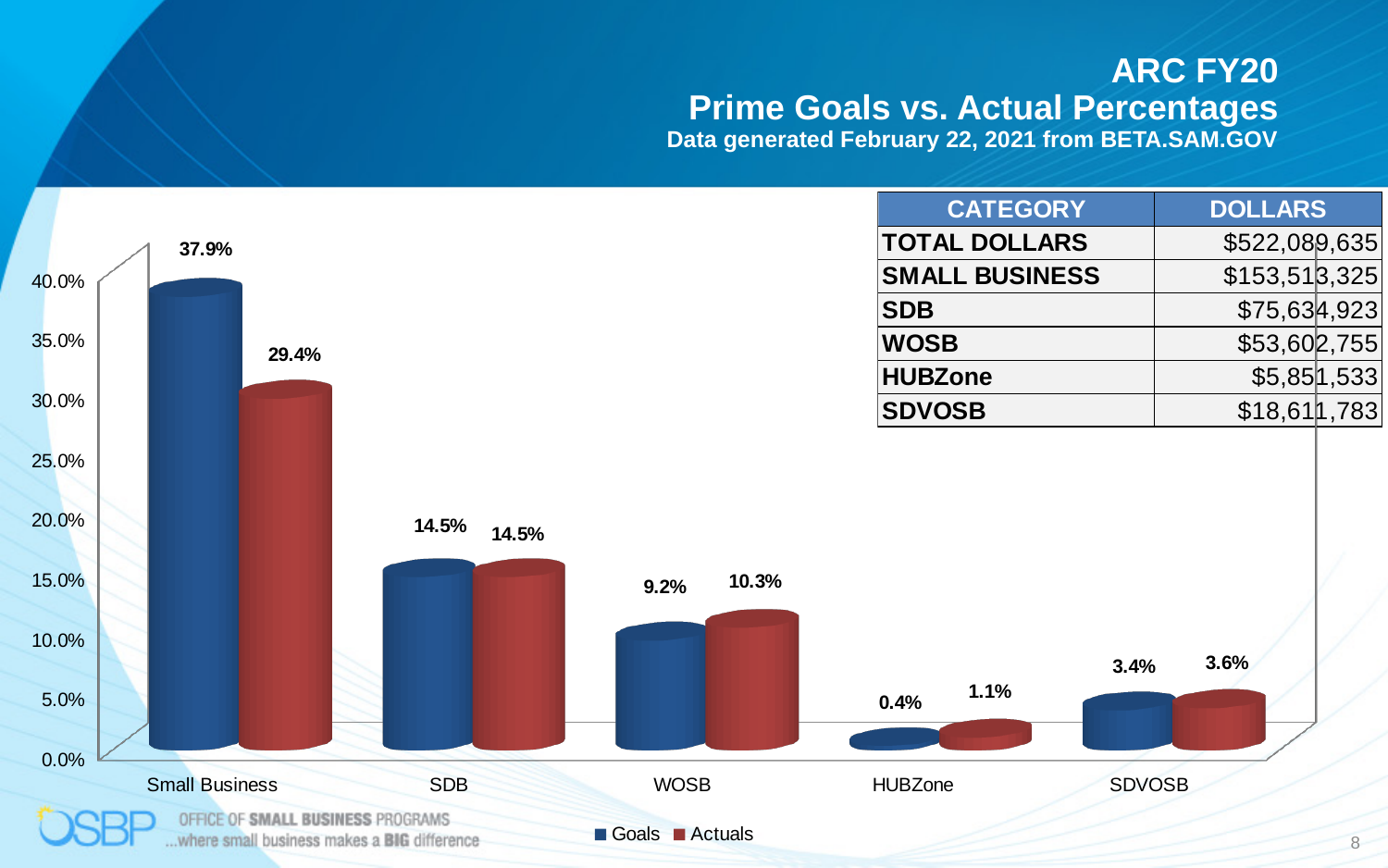
What is the Actuals value for SDVOSB? 3.6% What is the Actuals value for WOSB? 10.3% Which category has the highest Goals value? Small Business How many series does the chart legend list? 2 How many categories are shown on the x axis of the chart? 5 What is the Actuals value for Small Business? 29.4% Which is larger for WOSB, the Goals value or the Actuals value? Actuals Which category has the lowest Actuals value? HUBZone What is the difference between the Goals and Actuals values for Small Business? 8.5 percentage points What kind of chart is shown on the slide? Bar chart What is the Goals value for HUBZone? 0.4% What is the Goals value for Small Business? 37.9%